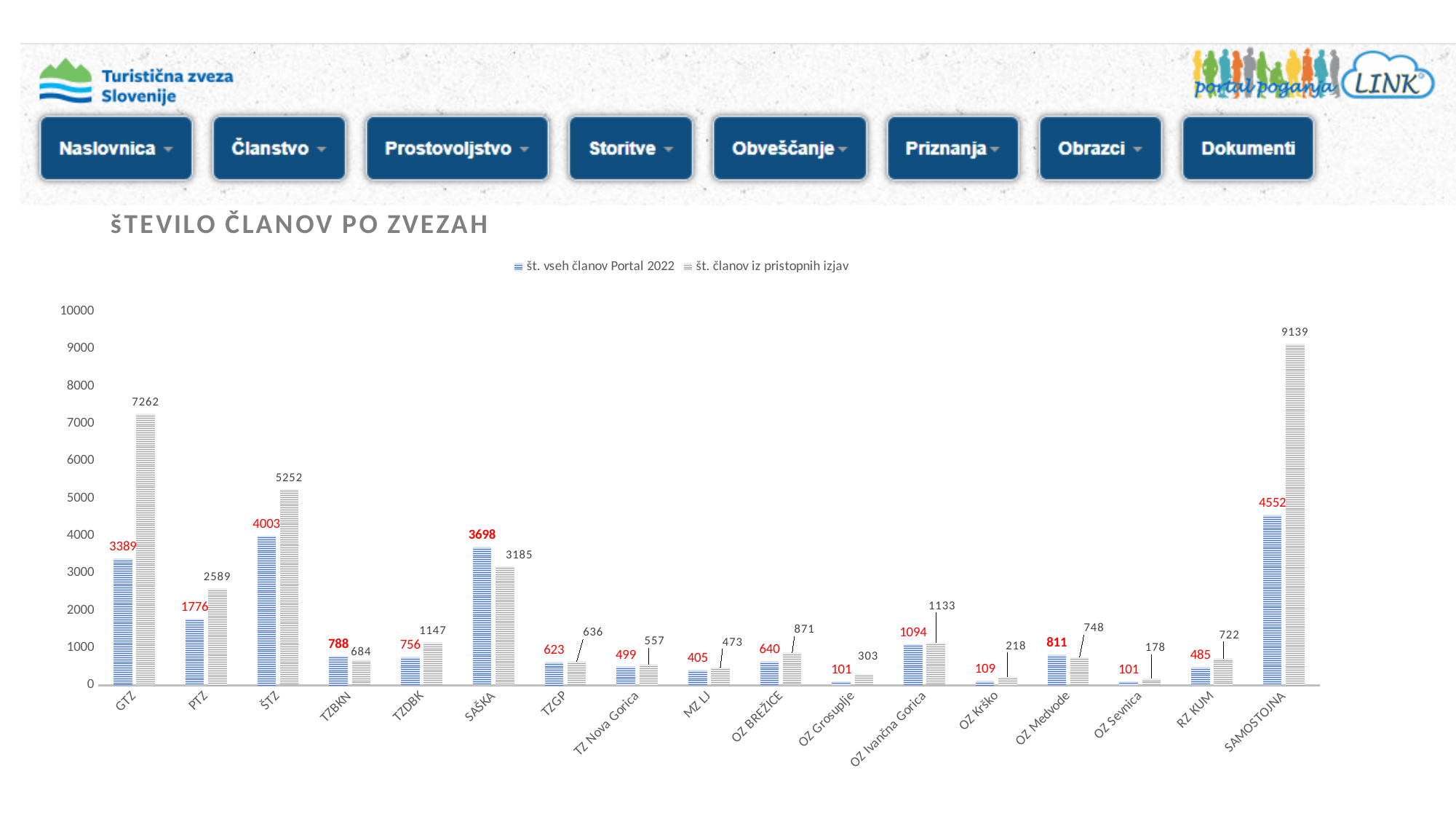
Which category has the highest value for 'št. članov iz pristopnih izjav'? SAMOSTOJNA What is the title of the chart? šTEVILO ČLANOV PO ZVEZAH For SAŠKA, which series has the larger value: 'št. vseh članov Portal 2022' or 'št. članov iz pristopnih izjav'? št. vseh članov Portal 2022 How many series does the legend list? 2 What is the value of 'št. vseh članov Portal 2022' for OZ Ivančna Gorica? 1094 What kind of chart is shown on the slide? bar chart What is the value of 'št. vseh članov Portal 2022' for GTZ? 3389 Is the value of 'št. članov iz pristopnih izjav' for ŠTZ greater or less than 5000? greater How many categories are shown on the x axis? 17 Which category has the lowest value for 'št. članov iz pristopnih izjav'? OZ Sevnica What is the value of 'št. članov iz pristopnih izjav' for SAMOSTOJNA? 9139 What is the difference between 'št. članov iz pristopnih izjav' and 'št. vseh članov Portal 2022' for GTZ? 3873